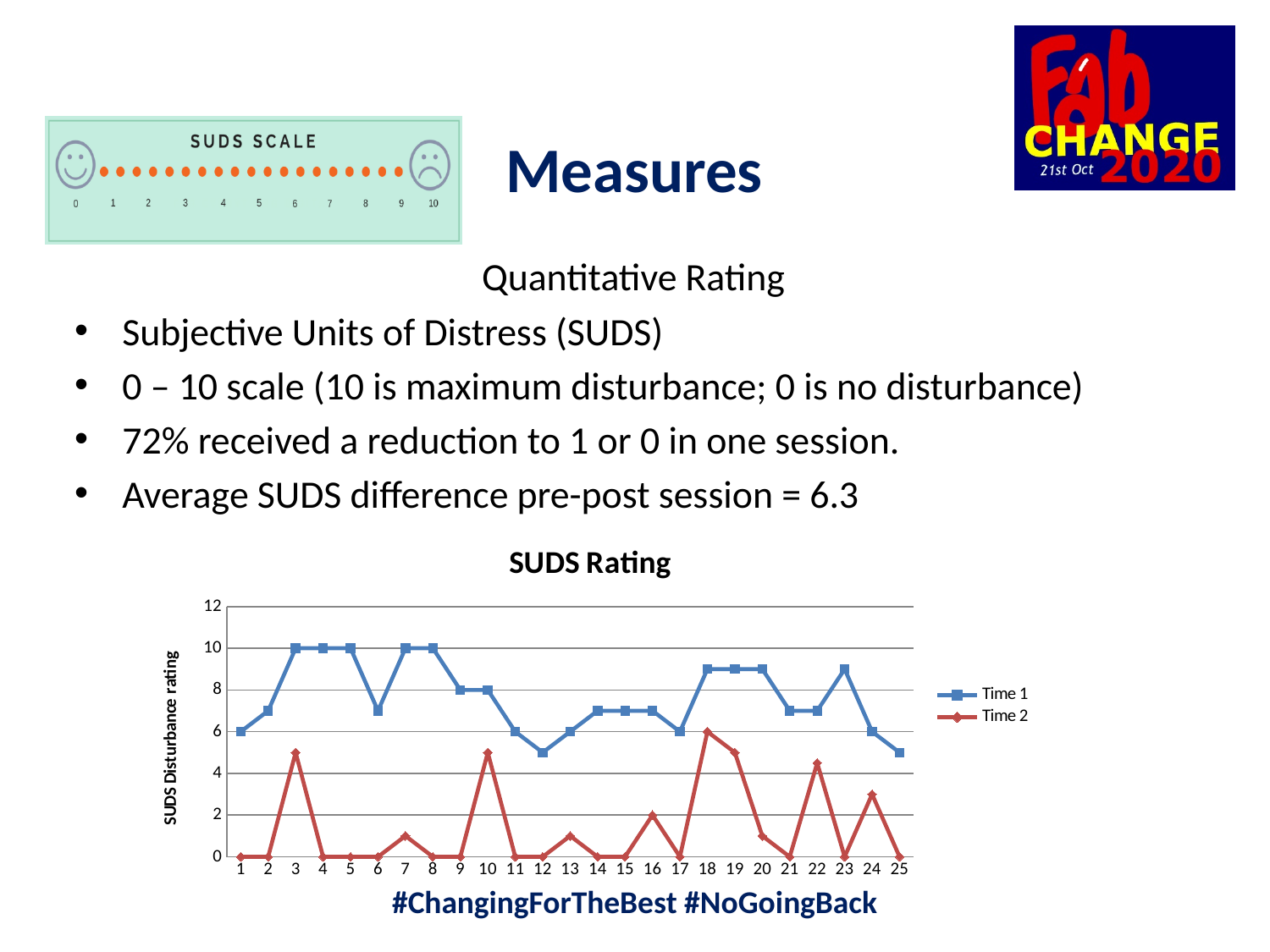
How many points are plotted along the x axis of the SUDS Rating chart? 25 What is the Time 1 value at point 3 in the SUDS Rating chart? 10 At point 10, which series has the larger value, Time 1 or Time 2? Time 1 What is the label on the vertical axis of the SUDS Rating chart? SUDS Disturbance rating What is the difference between the Time 1 value at point 3 and the Time 1 value at point 1? 4 What is the Time 2 value at point 18 in the SUDS Rating chart? 6 How many series does the legend of the SUDS Rating chart list? 2 What kind of chart is the SUDS Rating chart? line chart Is the Time 2 value at point 3 greater or less than 4? greater Is the Time 1 value at point 12 greater or less than 6? less What is the Time 2 value at point 16 in the SUDS Rating chart? 2 What is the Time 1 value at point 1 in the SUDS Rating chart? 6